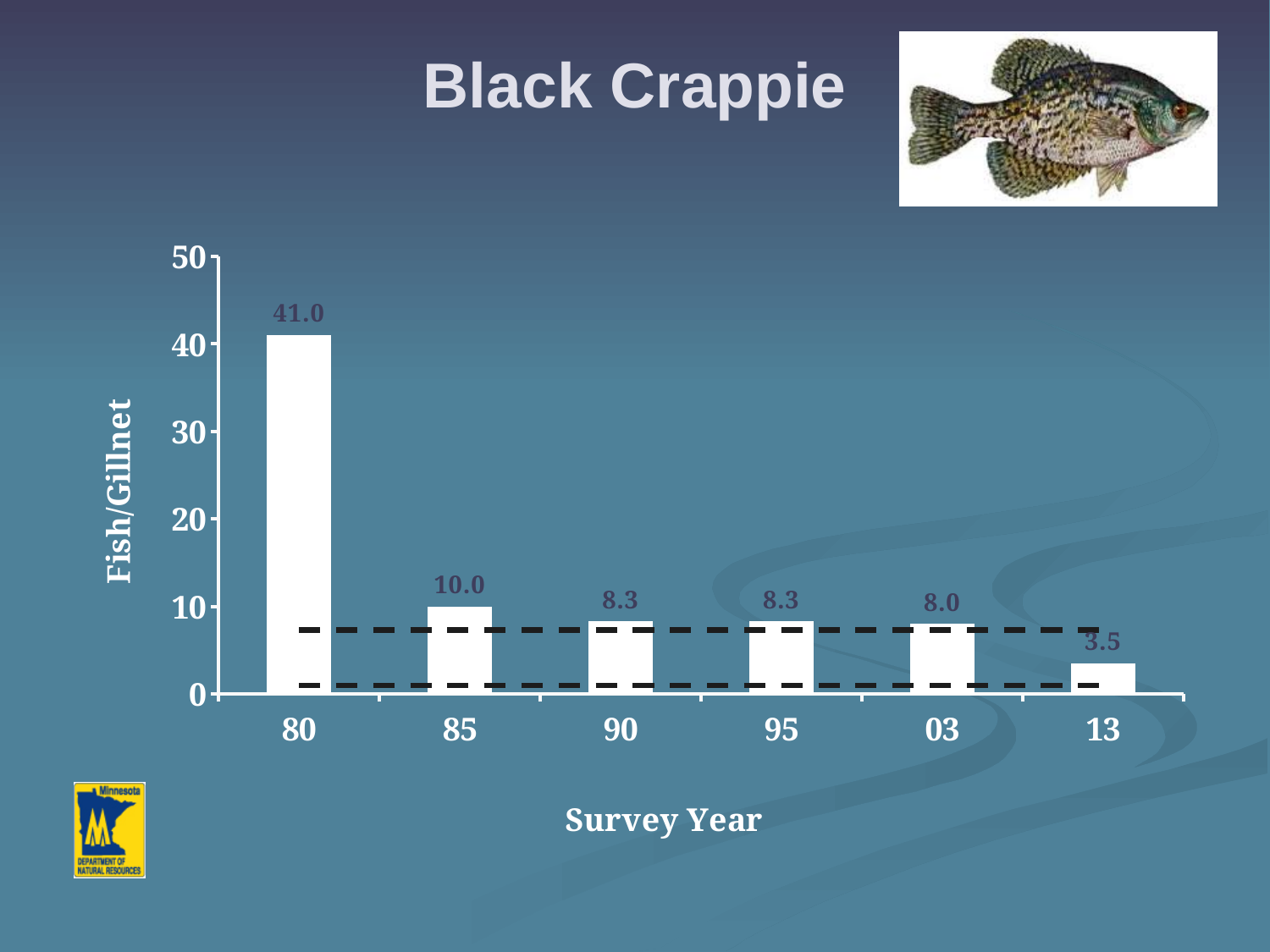
Is the Fish/Gillnet value for survey year 80 greater or less than 40? greater What kind of chart is shown on the slide? bar chart What is the title of the chart? Black Crappie What is the Fish/Gillnet value for survey year 13? 3.5 What is the Fish/Gillnet value for survey year 85? 10.0 What is the Fish/Gillnet value for survey year 80? 41.0 Which survey year has the highest Fish/Gillnet value? 80 Which survey year has a larger Fish/Gillnet value, 85 or 03? 85 Which survey year has the lowest Fish/Gillnet value? 13 What is the difference between the Fish/Gillnet values for survey years 03 and 13? 4.5 How many survey years are shown on the chart? 6 What is the difference between the Fish/Gillnet values for survey years 80 and 85? 31.0